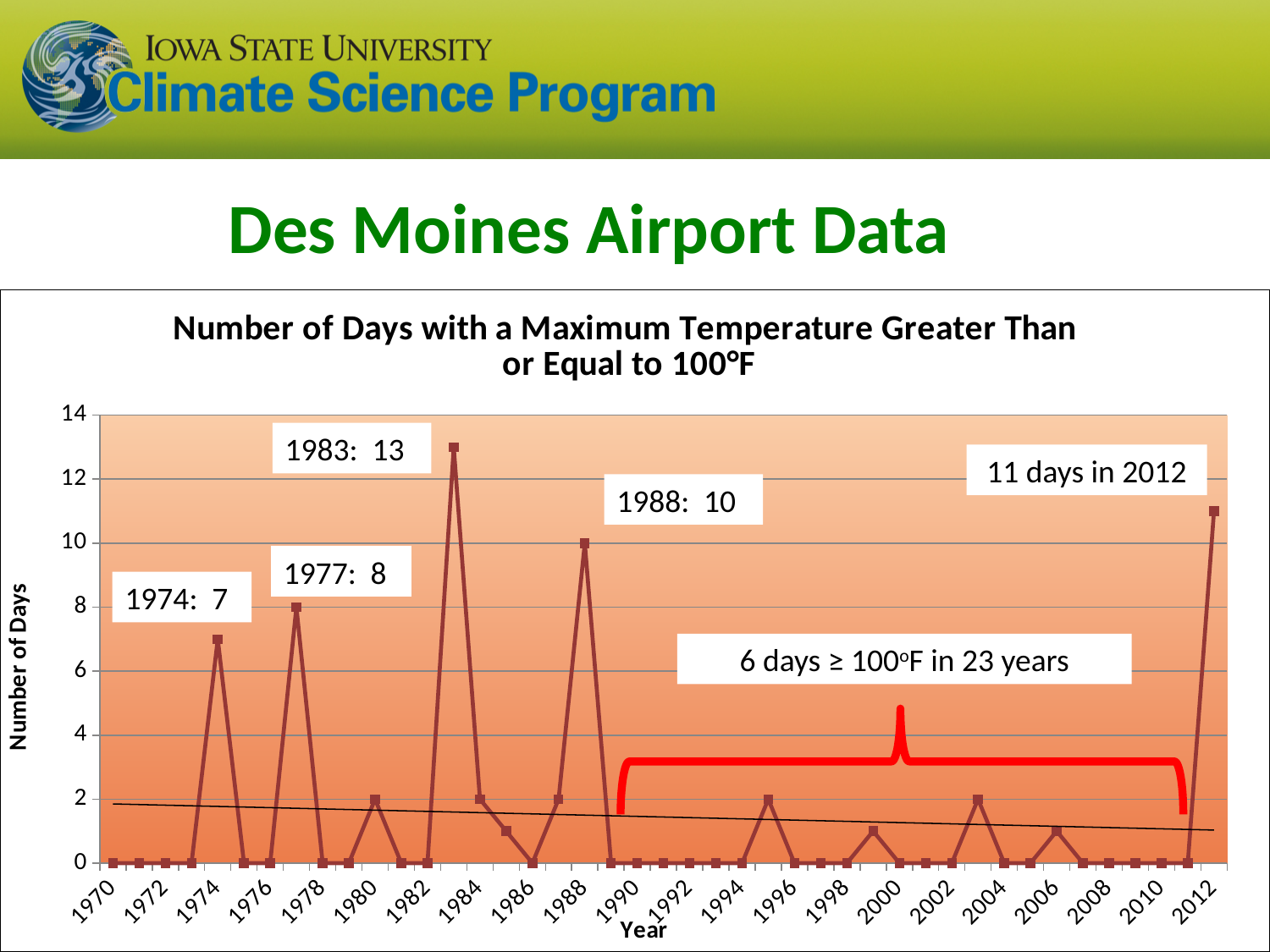
How many days with a maximum temperature of at least 100°F were recorded in 1983? 13 Which year has the highest number of days with a maximum temperature of at least 100°F? 1983 What is the title of the chart? Number of Days with a Maximum Temperature Greater Than or Equal to 100°F What is the label of the vertical axis? Number of Days Is the value for 1983 greater or less than 12? greater What is the difference between the number of days in 1983 and the number of days in 1988? 3 What kind of chart is shown on the slide? line chart Which year had more days with a maximum temperature of at least 100°F, 1974 or 1977? 1977 How many days with a maximum temperature of at least 100°F were recorded in 2012? 11 How many days with a maximum temperature of at least 100°F were recorded in 1974? 7 How many days with a maximum temperature of at least 100°F were recorded in 1988? 10 Does the black trend line drawn across the chart rise or fall from 1970 to 2012? fall